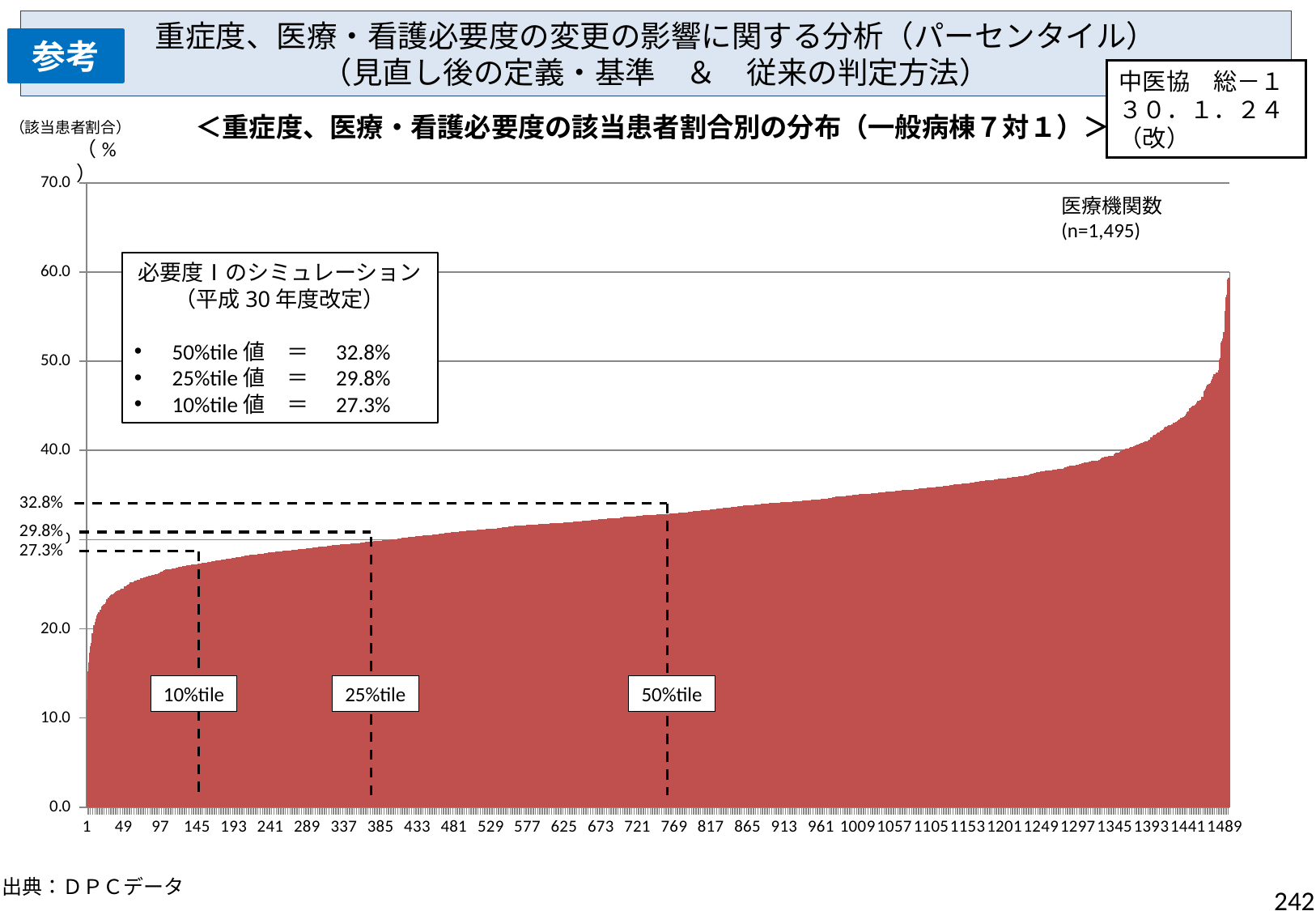
50%tile値と25%tile値の差はいくつですか？ 3.0% 50%tile値と10%tile値の差はいくつですか？ 5.5% このグラフの出典は何ですか？ ＤＰＣデータ グラフ右端の最も高い医療機関の該当患者割合は、50.0より大きいですか、小さいですか？ 大きい グラフ中に示された10%tile値はいくつですか？ 27.3% 25%tile値と10%tile値の差はいくつですか？ 2.5% グラフ中に示された25%tile値はいくつですか？ 29.8% グラフに示された医療機関数（n）はいくつですか？ 1,495 グラフ中の「必要度Ⅰのシミュレーション」の枠に示された50%tile値はいくつですか？ 32.8% 横軸に沿って右へ進むと、該当患者割合は上昇していますか、下降していますか？ 上昇 50%tile値と10%tile値では、どちらが大きいですか？ 50%tile値 このグラフはどの種類のグラフですか？ 棒グラフ